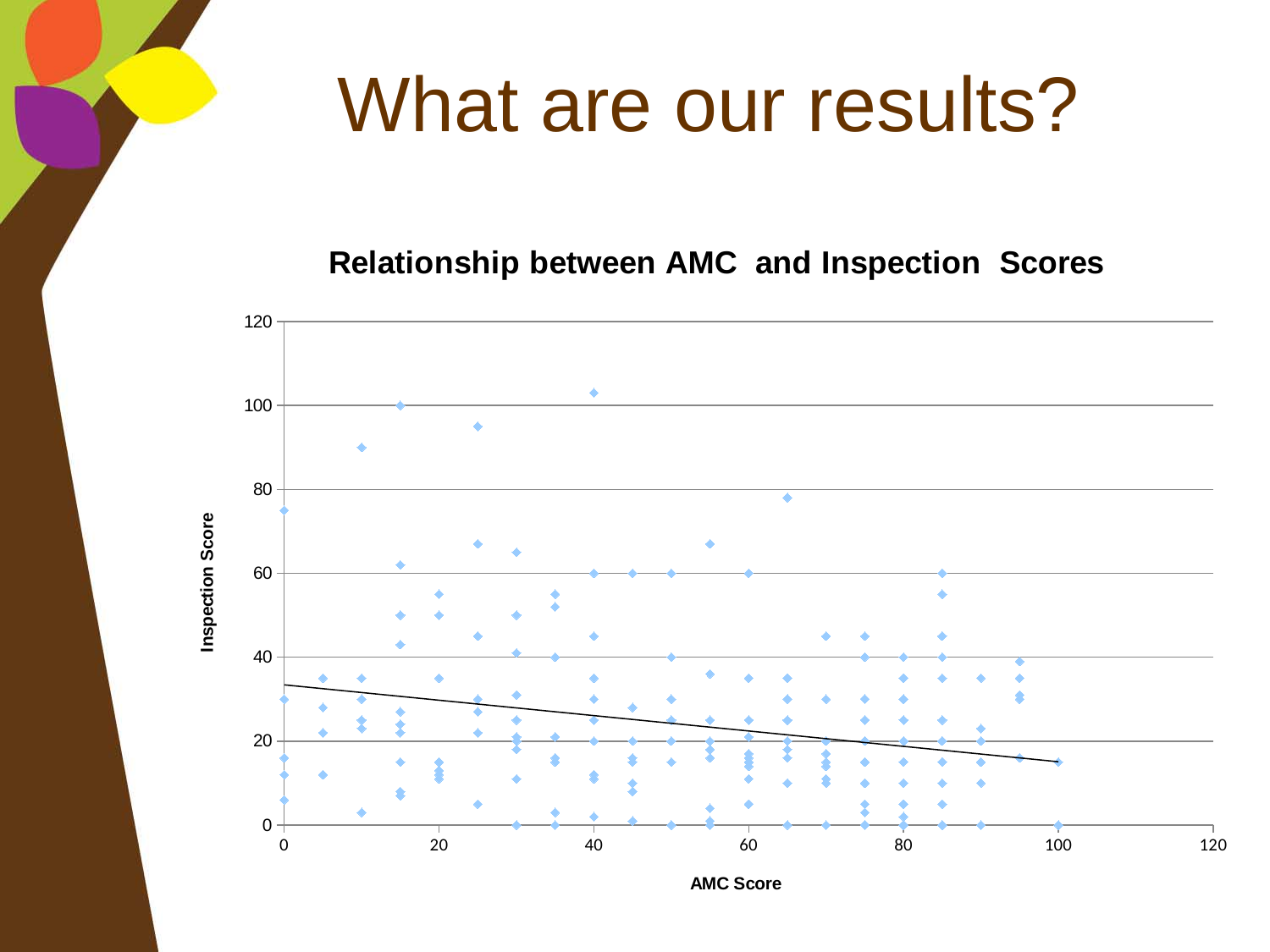
Is the value of the trend line at an AMC Score of 0 greater or less than 40? less Is the value of the trend line at an AMC Score of 100 greater or less than 20? less Is the value of the trend line at an AMC Score of 0 greater or less than 20? greater As AMC Score increases along the x axis, does the trend line rise or fall? Fall What is the title of the chart? Relationship between AMC and Inspection Scores What is the label of the horizontal axis? AMC Score What kind of chart is shown on the slide? Scatter chart